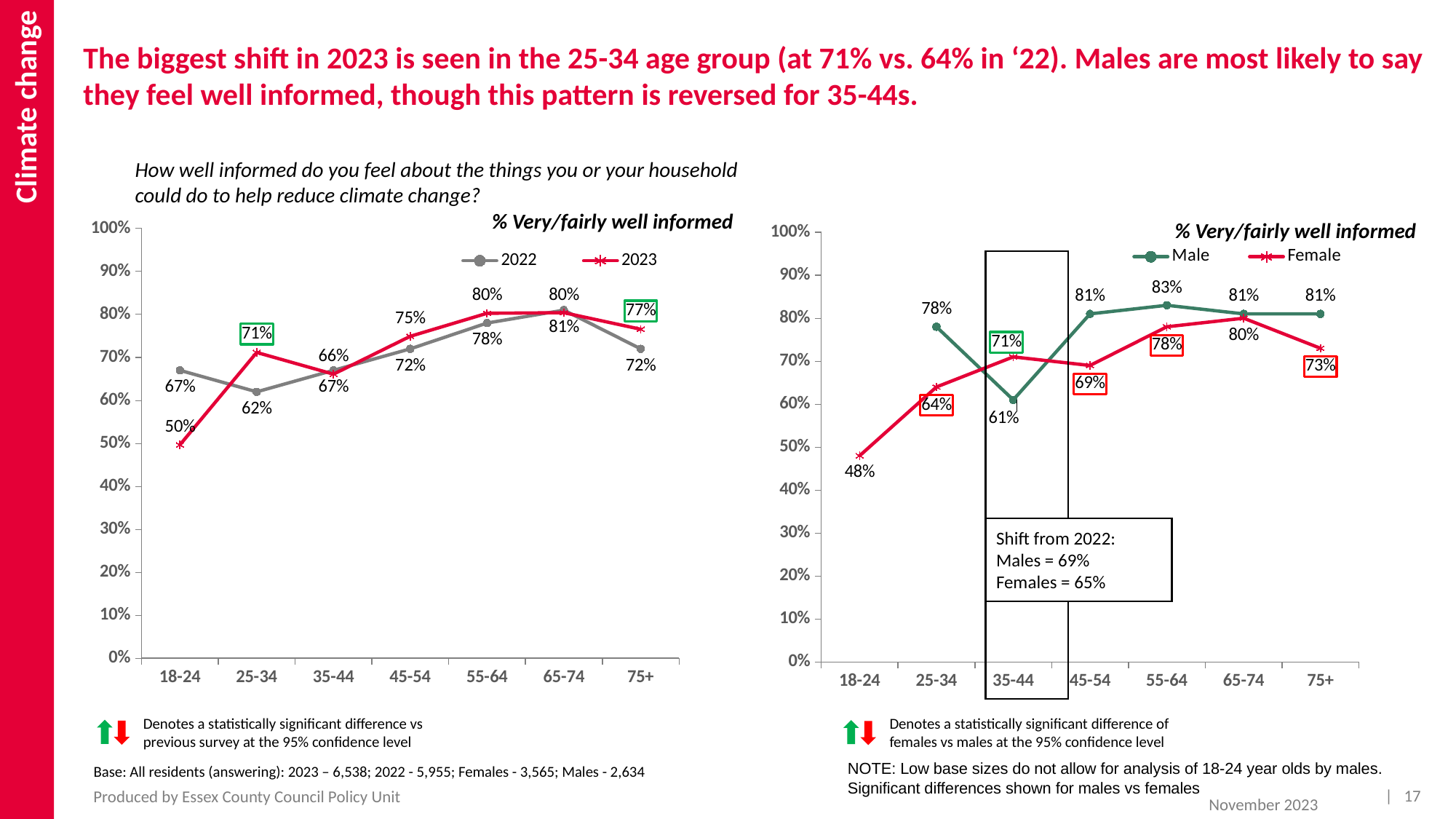
On the left chart, what is the difference between the 2023 and 2022 values for the 75+ age group? 5 percentage points On the left chart, what is the 2023 value for the 25-34 age group? 71% On the right chart, what is the difference between the Male and Female values for the 25-34 age group? 14 percentage points On the left chart, what is the 2022 value for the 18-24 age group? 67% On the left chart, which age group has the lowest 2023 value? 18-24 What kind of chart is the right chart? Line chart On the left chart, how many series does the legend list? 2 On the right chart, what is the Female value for the 35-44 age group? 71% On the right chart, which age group has the highest Male value? 55-64 On the left chart, which is larger for the 18-24 age group, the 2022 value or the 2023 value? 2022 On the right chart, how many age group categories are shown on the x axis? 7 On the right chart, which is larger for the 45-54 age group, the Male value or the Female value? Male